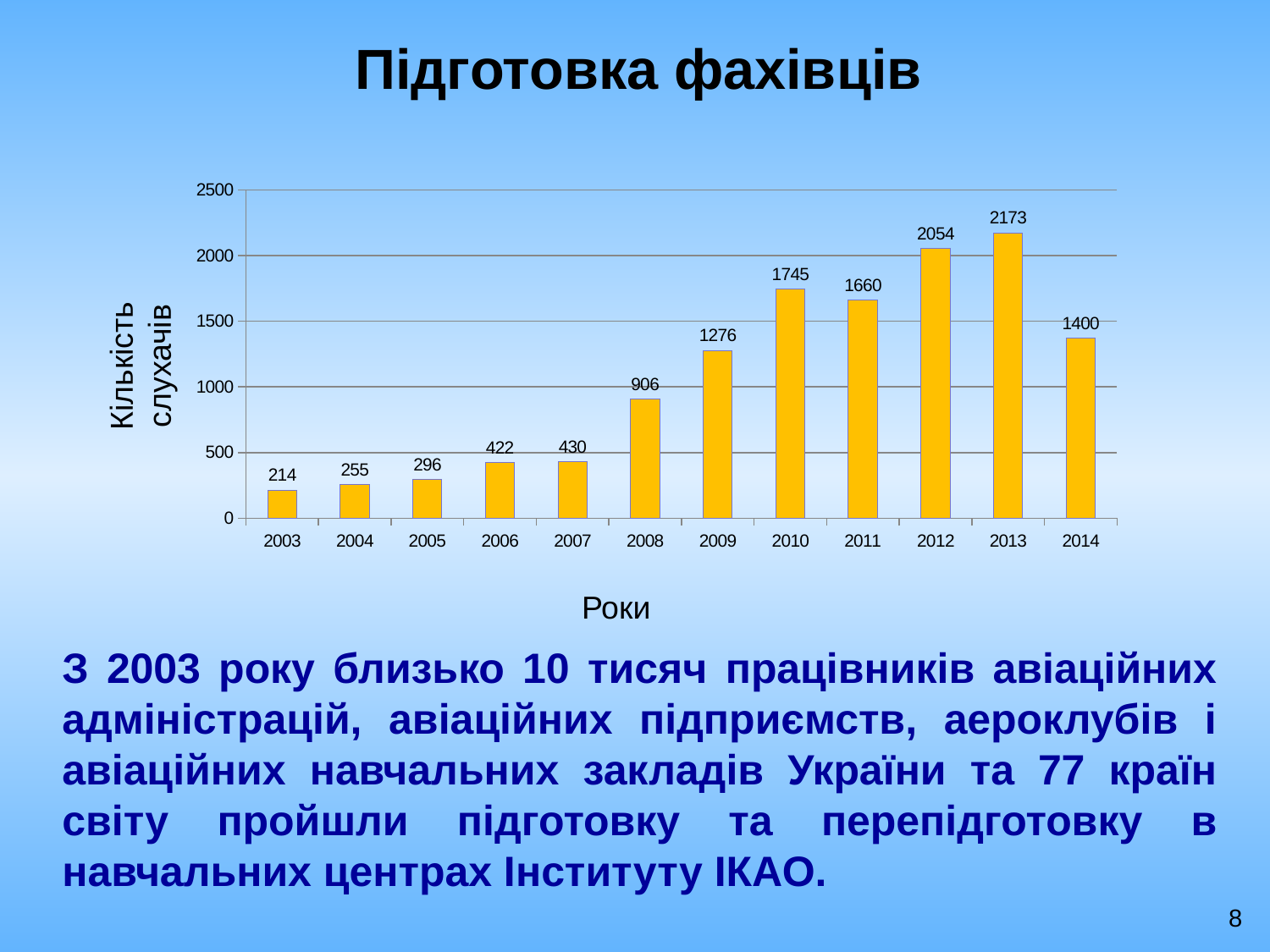
What is the value for 2014? 1400 What is the value for 2003? 214 Which year has the highest value? 2013 Do the values rise or fall from 2003 to 2010? rise Which is larger, the value for 2011 or the value for 2014? 2011 Is the value for 2009 greater or less than 1000? greater What kind of chart is shown on the slide? bar chart What is the difference between the values for 2013 and 2012? 119 What is the value for 2010? 1745 How many years are shown on the x axis? 12 What is the label of the x axis? Роки Which year has the lowest value? 2003